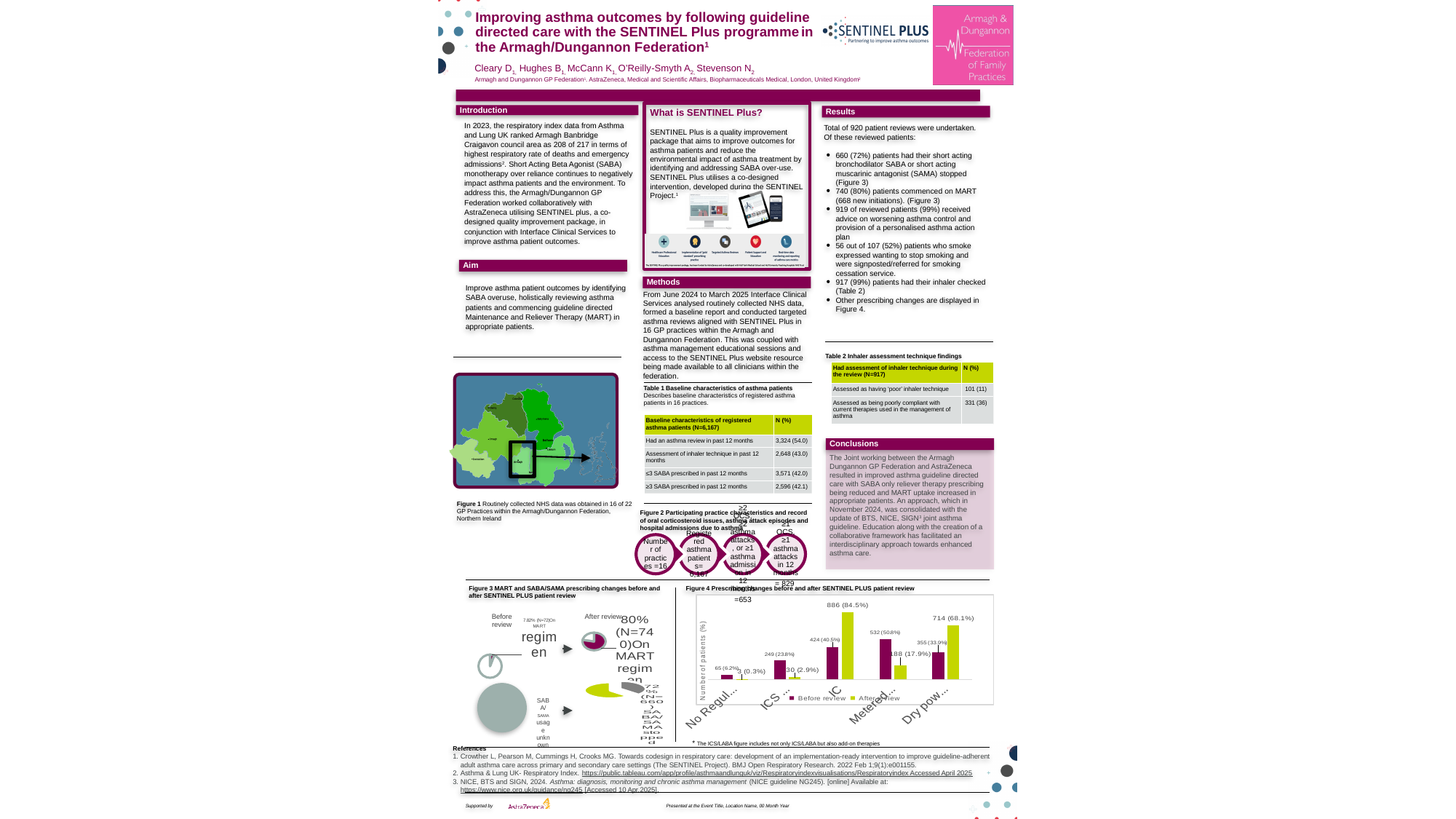
What kind of chart is Figure 4 (Prescribing changes before and after SENTINEL PLUS patient review)? Bar chart How many categories are shown on the x axis of Figure 4? 5 In Figure 4, for the fourth category (Metered...), which is larger: Before review or After review? Before review In Figure 4, for the third category, what is the difference in number of patients between After review (886) and Before review (424)? 462 What is the y-axis title of Figure 4? Number of patients (%) In Figure 4, what is the highest value shown on any bar? 886 (84.5%) In Figure 4, what is the After review value for the last category (Dry pow...)? 714 (68.1%) In Figure 4, what is the lowest value shown on any bar? 3 (0.3%) In Figure 4, what is the Before review value for the first category (No Regul...)? 65 (6.2%) What are the two legend entries in Figure 4? Before review, After review In Figure 3, what percentage of patients were on a MART regimen after review? 80% (N=740) How many series does the legend of Figure 4 list? 2